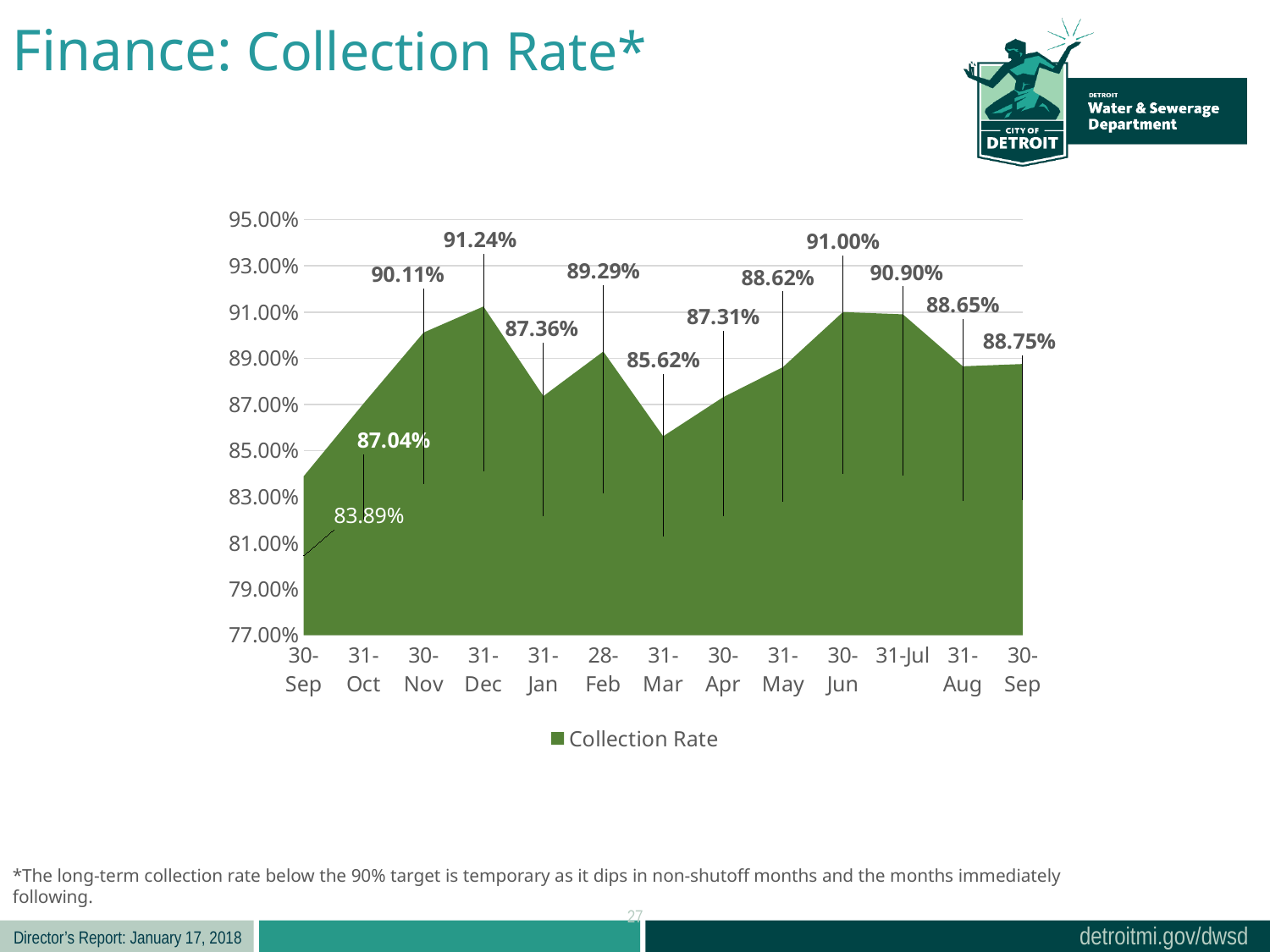
Which month has the lowest collection rate? 30-Sep (the first point) What is the collection rate for the last point on the x axis, 30-Sep? 88.75% Which month has the highest collection rate? 31-Dec What is the collection rate for 31-Mar? 85.62% How many series does the legend list? 1 Which is larger, the collection rate for 30-Jun or for 31-Jul? 30-Jun How many data points are plotted on the chart? 13 What is the difference between the collection rate for 31-Dec and the collection rate for 31-Mar? 5.62% What is the collection rate for 31-Dec? 91.24% What kind of chart is shown on the slide? Area chart What is the collection rate for 30-Jun? 91.00% Is the collection rate for 31-Oct greater or less than 89.00%? less